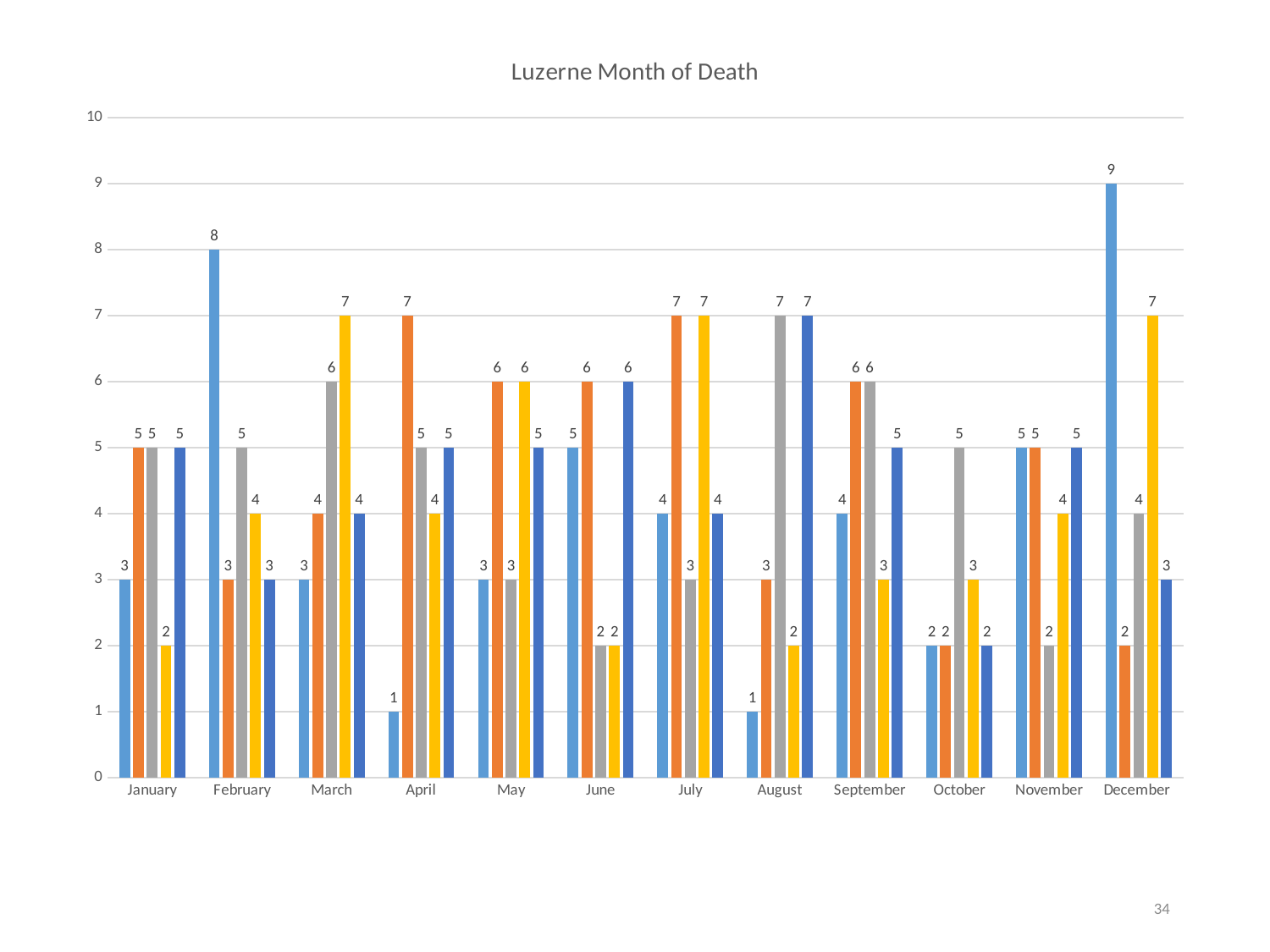
What kind of chart is shown on the slide? bar chart What is the difference between the light blue bar for December (9) and the light blue bar for April (1)? 8 Which month contains the tallest bar in the chart? December What is the value of the light blue bar for December? 9 What is the value of the dark blue bar for October? 2 What is the value of the orange bar for April? 7 What is the value of the light blue bar for February? 8 How many bars are plotted for each month? 5 What is the title of the chart? Luzerne Month of Death What is the value of the yellow bar for March? 7 Which is larger, the gray bar for August or the gray bar for October? August How many months are shown along the x axis? 12